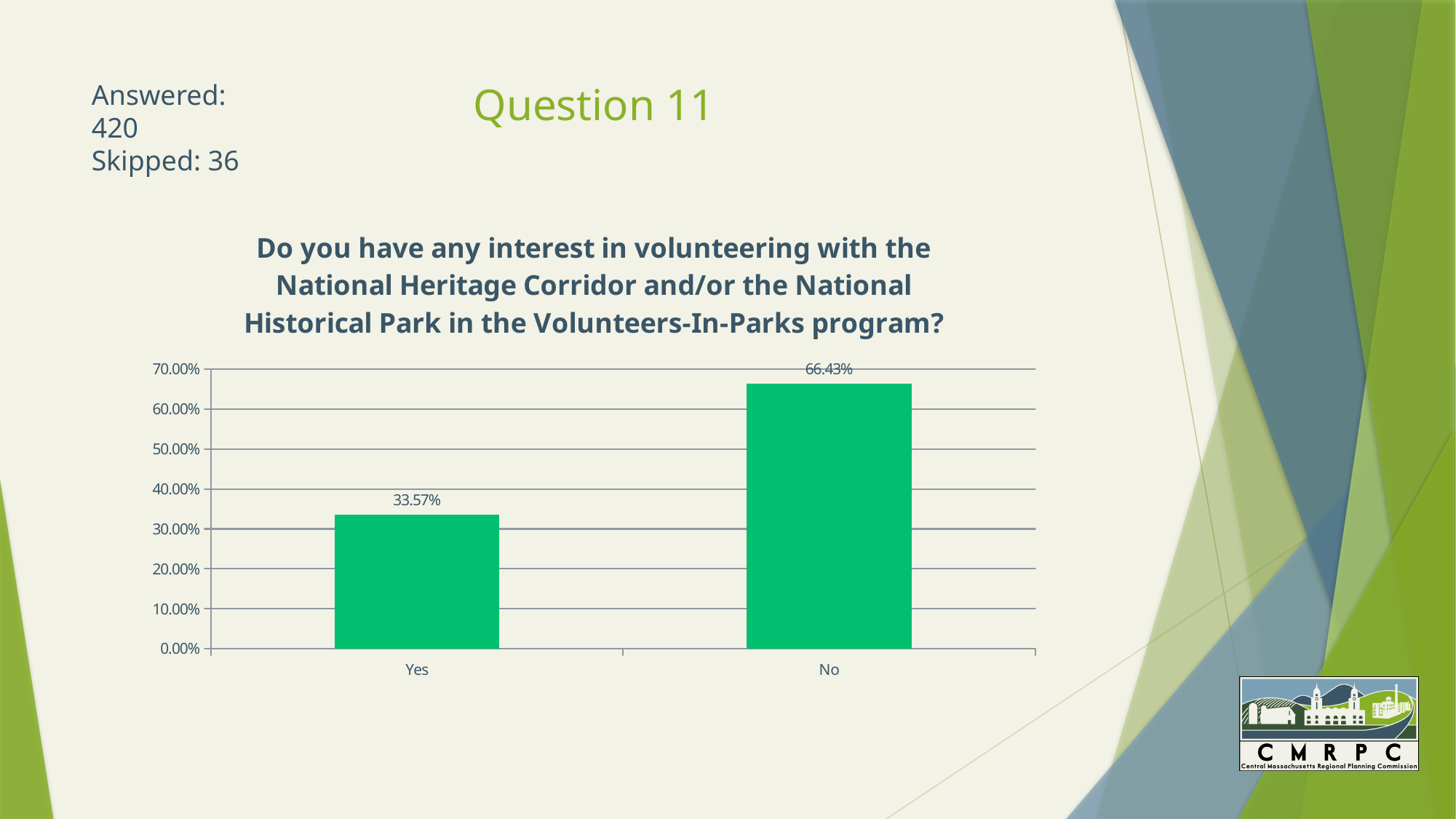
What colour are the bars in the chart? green What type of chart is shown on the slide? bar chart Which response has the highest percentage? No What percentage of respondents answered No? 66.43% How many response categories are shown on the chart? 2 What is the highest value shown on the vertical axis? 70.00% Which response has the lowest percentage? Yes What percentage of respondents answered Yes? 33.57% Is the value for Yes greater or less than 40.00%? less What is the difference in percentage points between the No and Yes responses? 32.86% Which is larger, the percentage for Yes or the percentage for No? No Is the value for No greater or less than 60.00%? greater